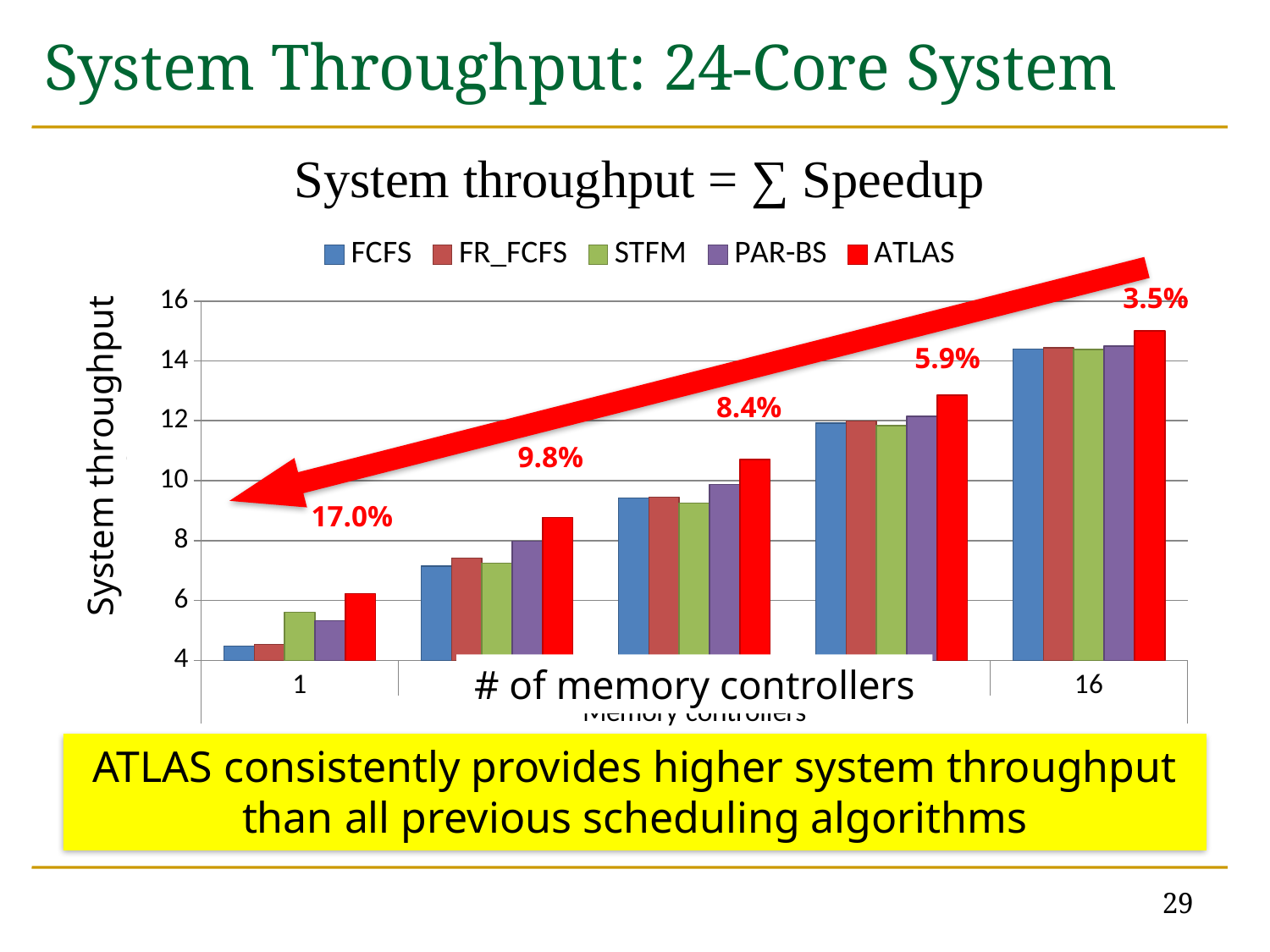
Is the ATLAS value at 16 memory controllers greater or less than 14? greater Do the system throughput values rise or fall as the number of memory controllers increases? rise How many series does the legend list? 5 What kind of chart is shown on the slide? bar chart How many groups of bars (memory controller counts) are plotted? 5 Which series are listed in the legend? FCFS, FR_FCFS, STFM, PAR-BS, ATLAS At 1 memory controller, which is larger: the ATLAS bar or the FCFS bar? ATLAS What percentage improvement is labelled above the bars for 1 memory controller? 17.0% Which series has the highest system throughput at 16 memory controllers? ATLAS Is the ATLAS value at 1 memory controller greater or less than 8? less What percentage improvement is labelled above the bars for 16 memory controllers? 3.5% Is the FCFS value at 1 memory controller greater or less than 6? less